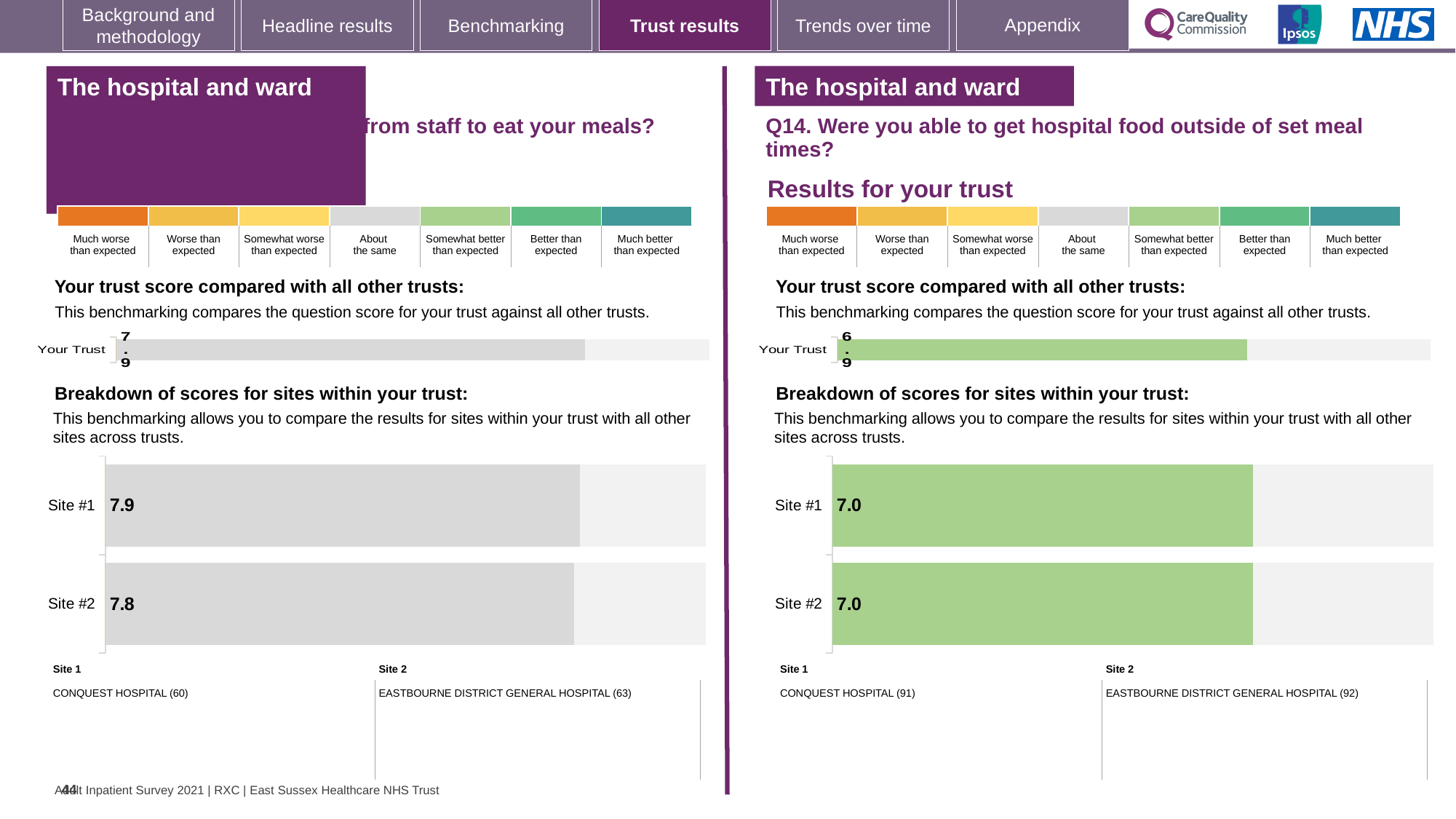
In the Q14 site breakdown chart on the right, what is the score for Site #1? 7.0 In the Q14 site breakdown chart on the right, what is the score for Site #2? 7.0 In the left-hand site breakdown chart, what is the difference between the Site #1 and Site #2 scores? 0.1 In the left-hand site breakdown chart, which site has the higher score? Site #1 On the right-hand side of the slide (Q14), what is the 'Your Trust' score shown in the trust score bar? 6.9 In the left-hand site breakdown chart, what is the score for Site #1? 7.9 How many sites are shown in the Q14 site breakdown chart on the right? 2 What type of chart is used for the site breakdown on the right-hand side of the slide? Bar chart In the Q14 site breakdown chart on the right, what colour are the bars for Site #1 and Site #2? Green According to the site key on the right-hand side, which hospital is Site 2 for Q14? EASTBOURNE DISTRICT GENERAL HOSPITAL (92) On the left-hand side of the slide, what is the 'Your Trust' score shown in the trust score bar? 7.9 In the left-hand site breakdown chart, what is the score for Site #2? 7.8